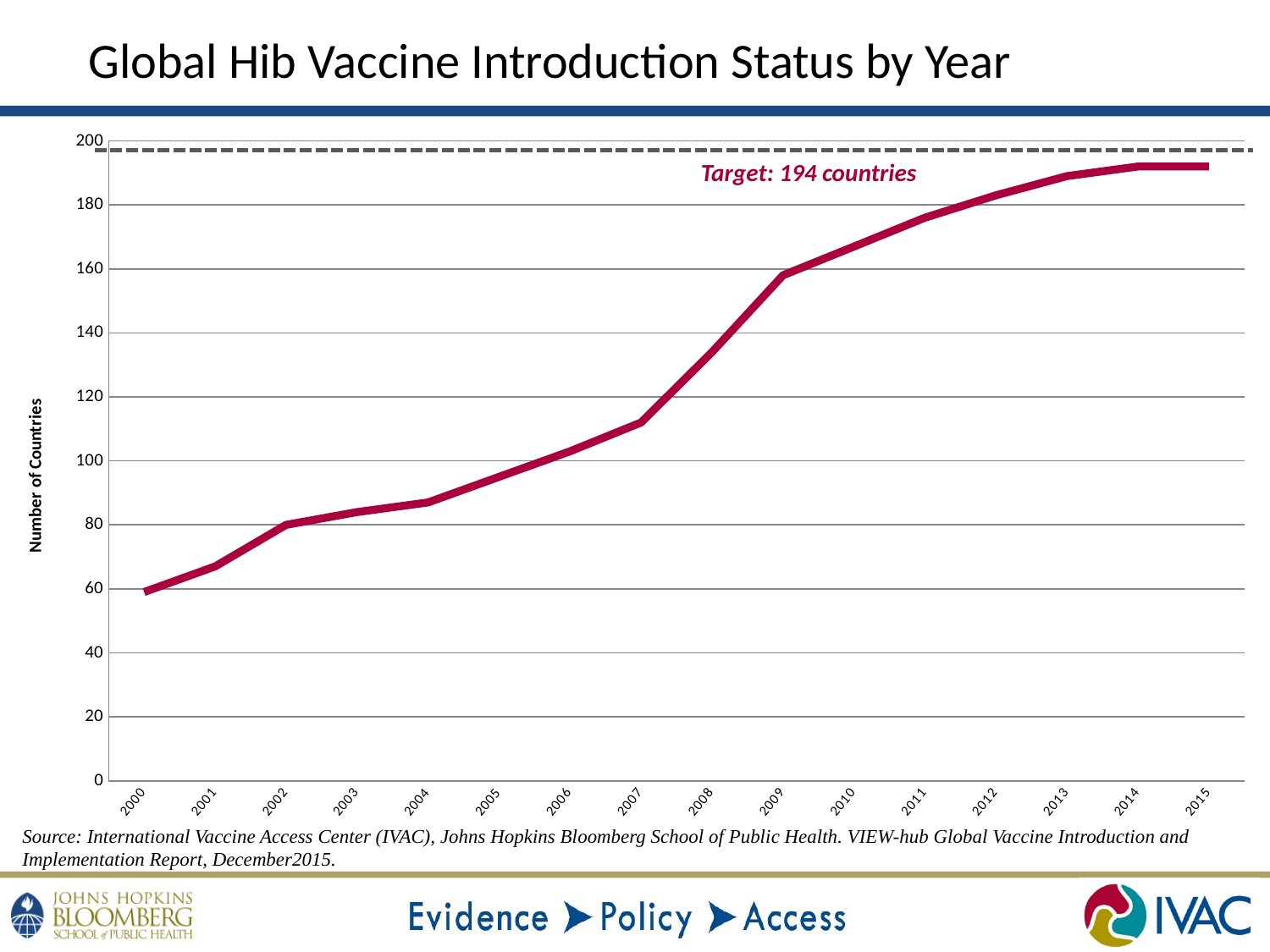
What target is labelled by the dashed line on the chart? Target: 194 countries What is the label of the y axis? Number of Countries Which is larger, the value for 2005 or the value for 2010? 2010 Is the value for 2015 greater or less than 200? less Is the value for 2007 greater or less than 100? greater Which year has the lowest number of countries? 2000 Do the values rise or fall from 2000 to 2015? rise How many years are plotted along the x axis? 16 What kind of chart is shown on the slide? line chart Is the value for 2012 greater or less than 180? greater